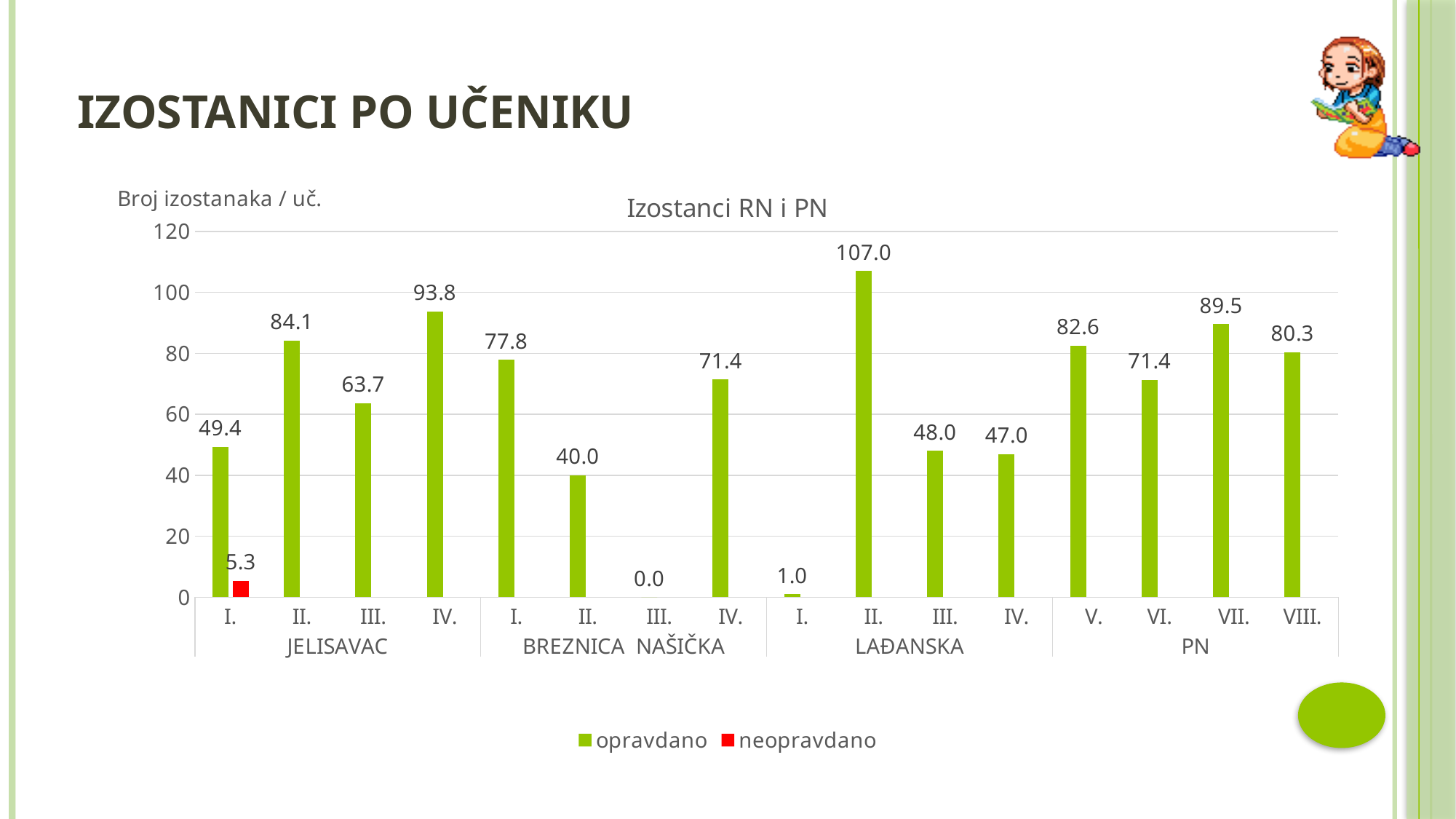
Which class has the highest opravdano value on the chart? II. LAĐANSKA What is the neopravdano value shown for class I. in JELISAVAC? 5.3 Which class has the lowest opravdano value on the chart? III. BREZNICA NAŠIČKA What kind of chart is shown on the slide? bar chart How many series does the legend list? 2 What is the opravdano value for class II. in LAĐANSKA? 107.0 How many classes (categories) are shown on the x axis? 16 What is the difference between the opravdano values for class II. and class III. in JELISAVAC? 20.4 Which is larger, the opravdano value for class V. in PN or class VIII. in PN? V. PN What is the opravdano value for class VII. in PN? 89.5 What is the opravdano value for class IV. in JELISAVAC? 93.8 What is the title of the chart? Izostanci RN i PN